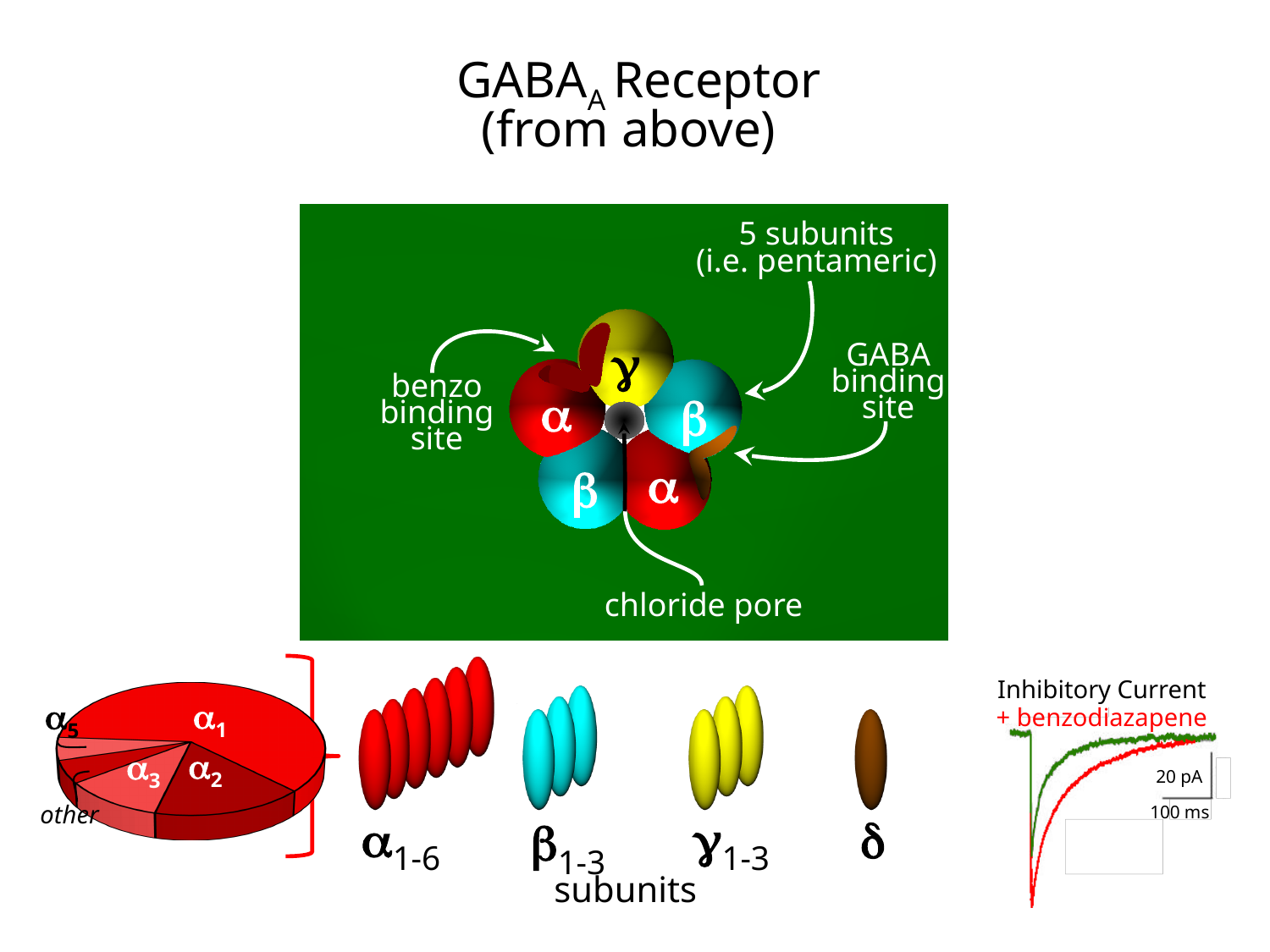
What kind of chart is shown at the bottom left of the slide? pie chart How many slices does the pie chart at the bottom left have? 5 In the Inhibitory Current graph at the bottom right, what is the value of the vertical scale bar? 20 pA How many traces are plotted in the Inhibitory Current graph at the bottom right? 2 In the Inhibitory Current graph at the bottom right, what does the red trace represent? + benzodiazapene In the pie chart at the bottom left, which slice is larger, α1 or α2? α1 In the pie chart at the bottom left, which slice is larger, α2 or α5? α2 In the pie chart at the bottom left, which slice is larger, α1 or α3? α1 Which slice of the pie chart at the bottom left is the largest? α1